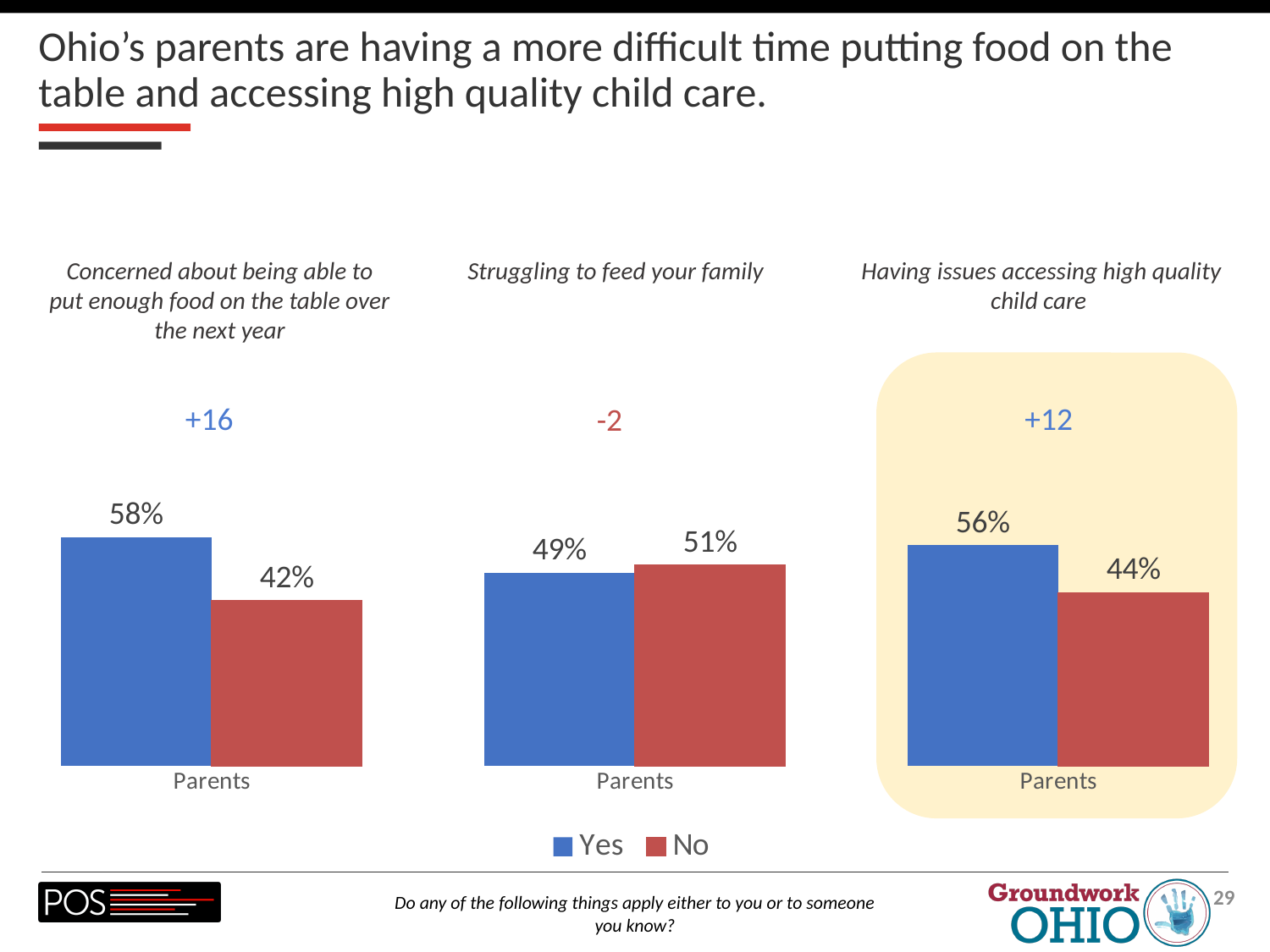
What kind of chart is the 'Struggling to feed your family' chart? Bar chart How many series does the legend list? 2 In the 'Having issues accessing high quality child care' chart, what is the difference between the Yes and No values? 12 In the 'Struggling to feed your family' chart, what is the value for No? 51% In the 'Having issues accessing high quality child care' chart, what is the value for No? 44% In the 'Concerned about being able to put enough food on the table over the next year' chart, what is the value for Yes? 58% In the 'Struggling to feed your family' chart, which is larger, Yes or No? No In the 'Having issues accessing high quality child care' chart, what is the value for Yes? 56% In the 'Having issues accessing high quality child care' chart, which is larger, Yes or No? Yes In the 'Concerned about being able to put enough food on the table over the next year' chart, what is the difference between the Yes and No values? 16 In the 'Concerned about being able to put enough food on the table over the next year' chart, what is the value for No? 42% In the 'Struggling to feed your family' chart, what is the value for Yes? 49%